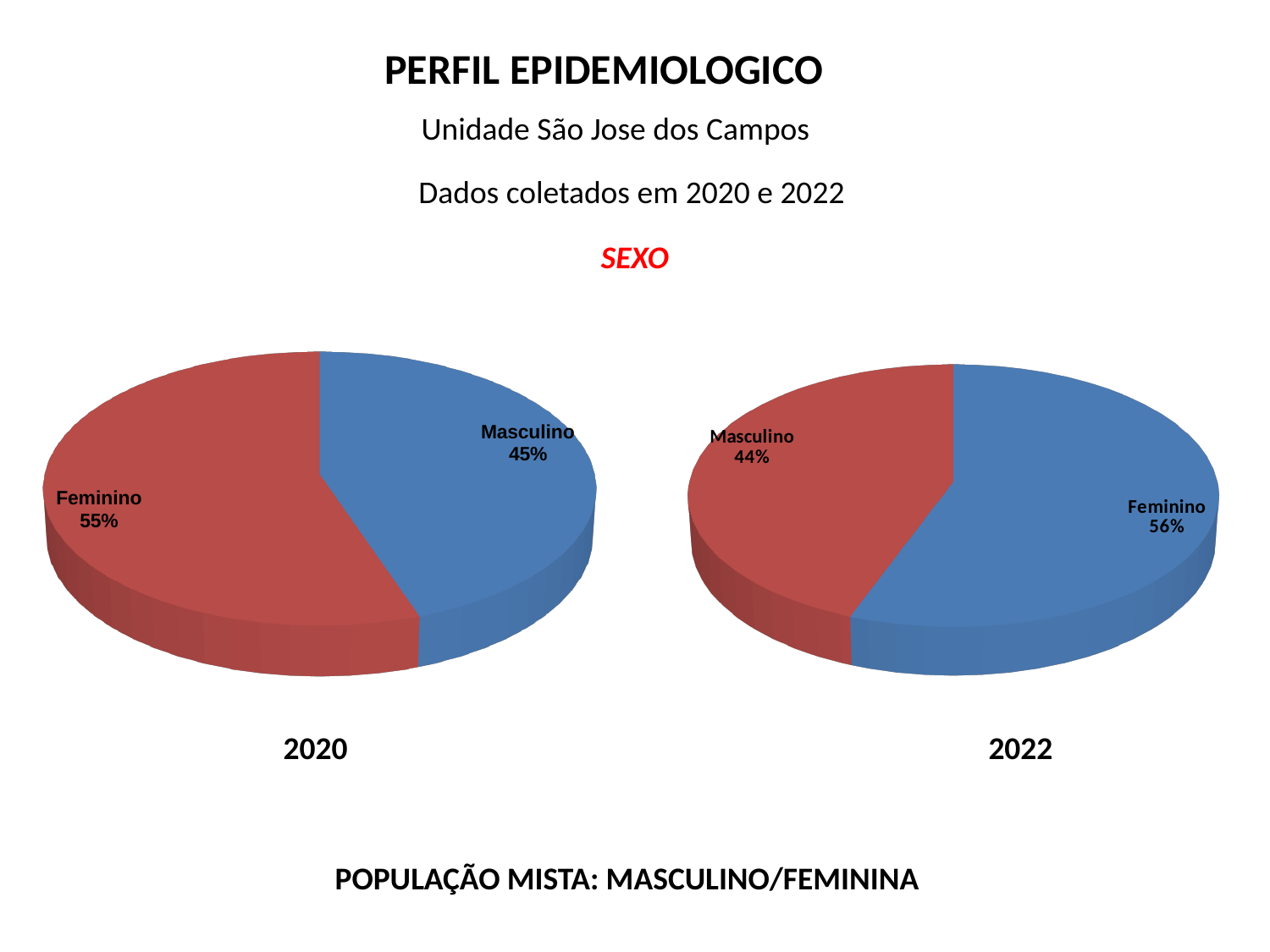
In the 2022 pie chart, what is the share for Masculino? 44% How many slices does the 2022 pie chart have? 2 In the 2022 pie chart, which category has the smallest slice? Masculino In the 2020 pie chart, what colour is the Feminino slice? Red In the 2022 pie chart, what is the difference between the Feminino and Masculino shares? 12% In the 2022 pie chart, what is the share for Feminino? 56% Is the Feminino share larger in the 2020 chart or the 2022 chart? 2022 In the 2020 pie chart, what is the share for Masculino? 45% In the 2020 pie chart, which category has the largest slice? Feminino In the 2020 pie chart, what is the difference between the Feminino and Masculino shares? 10% What kind of chart is used for the 2020 data? Pie chart In the 2020 pie chart, what is the share for Feminino? 55%